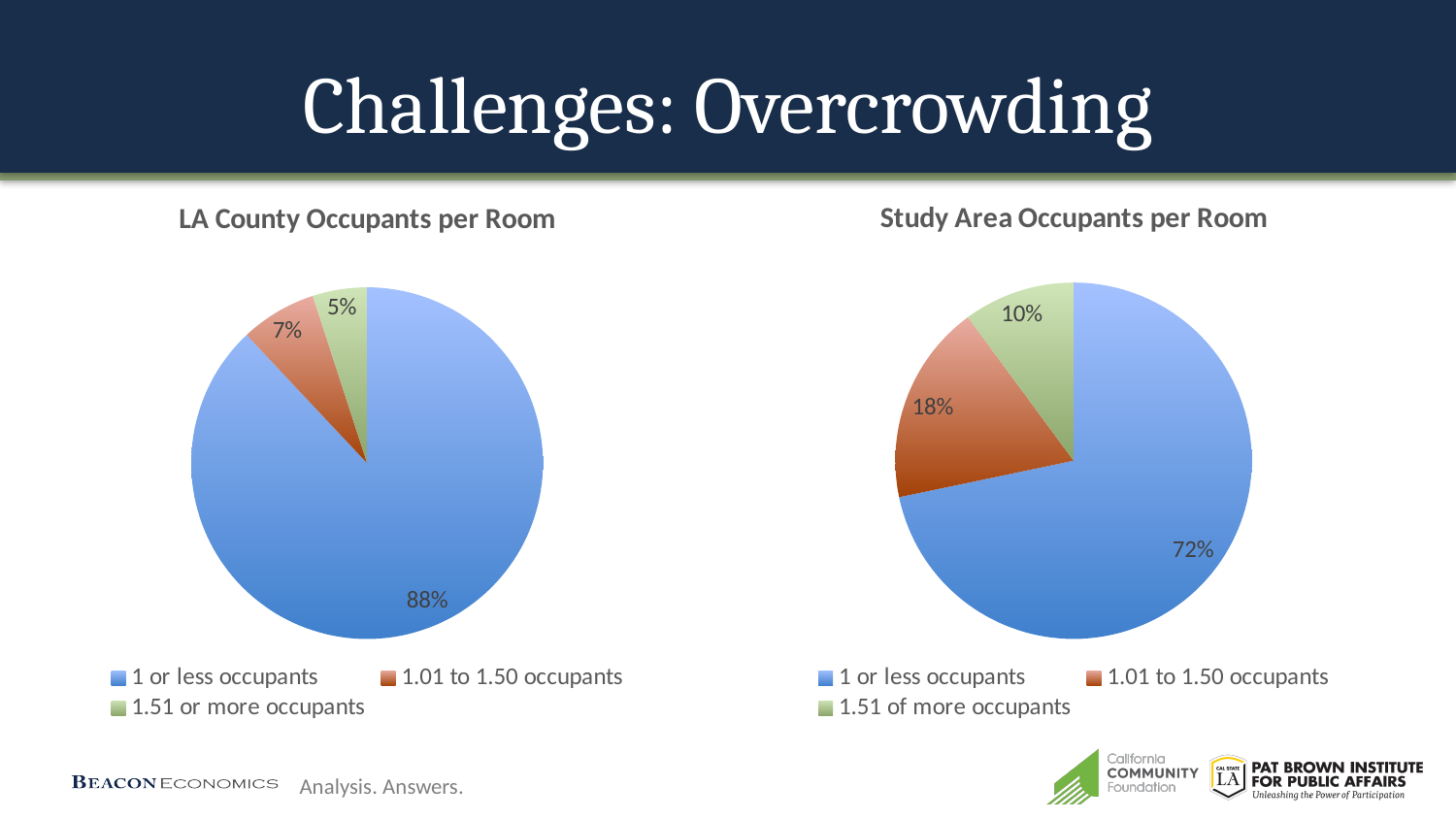
In the 'LA County Occupants per Room' chart, what share is shown for 1 or less occupants? 88% What is the difference between the 1.01 to 1.50 occupants share in the 'Study Area Occupants per Room' chart and the same category in the 'LA County Occupants per Room' chart? 11 percentage points In the 'Study Area Occupants per Room' chart, what share is shown for 1.51 of more occupants? 10% How many slices does the 'Study Area Occupants per Room' pie chart have? 3 In the 'Study Area Occupants per Room' chart, what share is shown for 1.01 to 1.50 occupants? 18% In the 'LA County Occupants per Room' chart, what share is shown for 1.01 to 1.50 occupants? 7% In the 'Study Area Occupants per Room' chart, what colour is the slice for 1.01 to 1.50 occupants? Orange How many entries does the legend of the 'LA County Occupants per Room' chart list? 3 In the 'LA County Occupants per Room' chart, which category has the smallest slice? 1.51 or more occupants What type of chart is 'LA County Occupants per Room'? Pie chart Which is larger: the 1 or less occupants share in the 'LA County Occupants per Room' chart or in the 'Study Area Occupants per Room' chart? LA County Occupants per Room In the 'Study Area Occupants per Room' chart, which category has the largest slice? 1 or less occupants